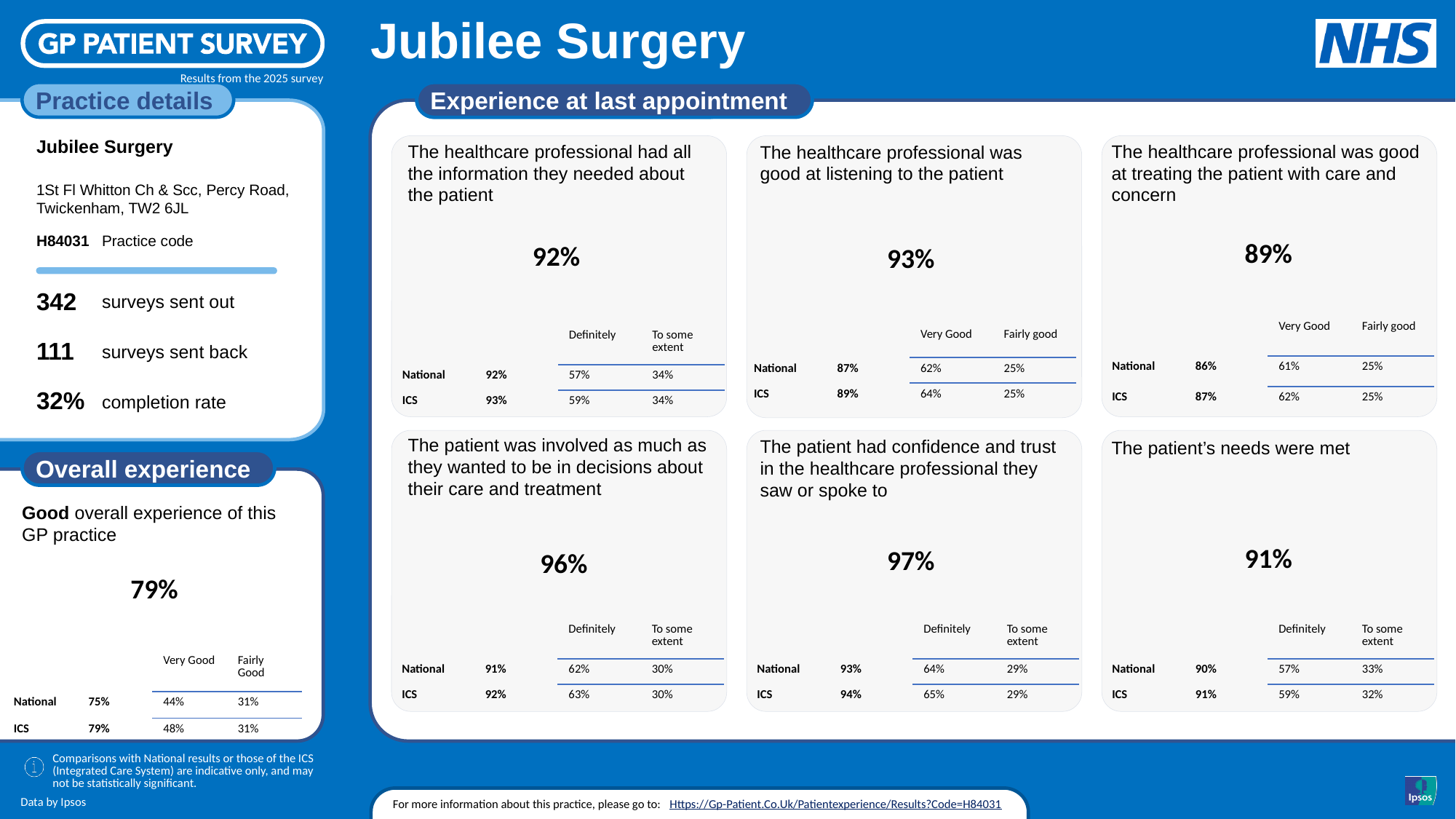
In the 'The patient was involved as much as they wanted to be in decisions about their care and treatment' panel, which is larger: the practice's percentage or the ICS value? the practice's percentage In the 'The patient had confidence and trust in the healthcare professional they saw or spoke to' panel, what is the ICS value? 94% In the 'The patient's needs were met' panel, what is the National value? 90% In the 'Overall experience' panel, what is the practice's percentage for good overall experience of this GP practice? 79% Among the six 'Experience at last appointment' panels, which question has the lowest practice percentage? The healthcare professional was good at treating the patient with care and concern How many question panels are shown under the 'Experience at last appointment' heading? 6 In the 'The healthcare professional was good at listening to the patient' panel, what is the practice's headline percentage? 93% In the 'Overall experience' panel, what is the difference between the practice's percentage and the National value? 4% In the 'Overall experience' panel, what is the National 'Very Good' percentage? 44% In the 'The healthcare professional had all the information they needed about the patient' panel, what is the ICS 'Definitely' percentage? 59% In the 'The healthcare professional was good at treating the patient with care and concern' panel, what is the difference between the practice's percentage and the National value? 3% Among the six 'Experience at last appointment' panels, which question has the highest practice percentage? The patient had confidence and trust in the healthcare professional they saw or spoke to